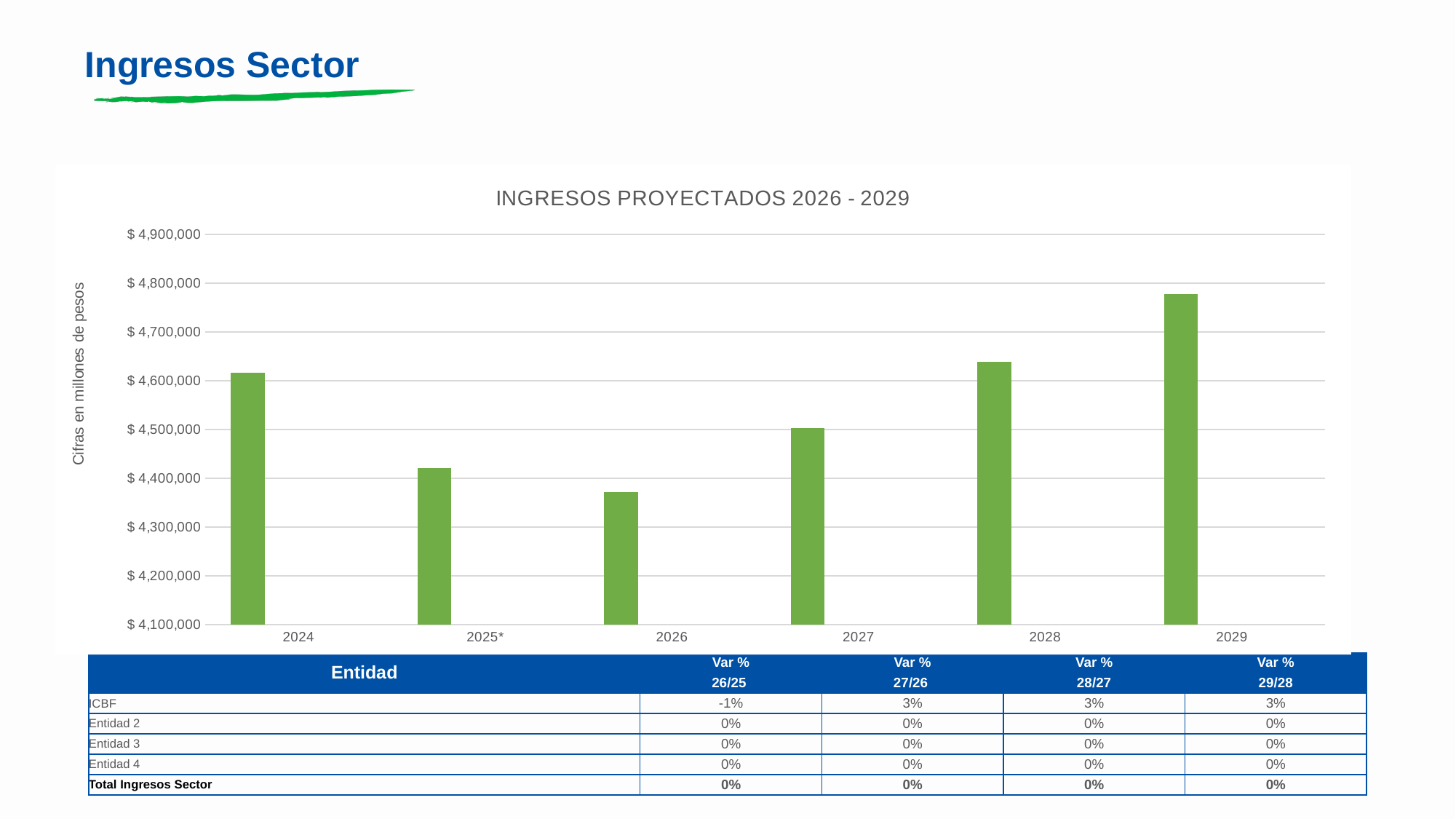
Which is larger, the value for 2027 or the value for 2025*? 2027 Is the value for 2024 greater or less than $ 4,500,000? greater Is the value for 2028 greater or less than $ 4,600,000? greater Which year has the highest bar in the chart? 2029 Is the value for 2029 greater or less than $ 4,700,000? greater Do the values rise or fall from 2026 to 2029? Rise What kind of chart is shown on the slide? Bar chart How many years are shown on the x axis of the chart? 6 Which year has the lowest bar in the chart? 2026 What is the label of the vertical axis of the chart? Cifras en millones de pesos What is the title of the chart? INGRESOS PROYECTADOS 2026 - 2029